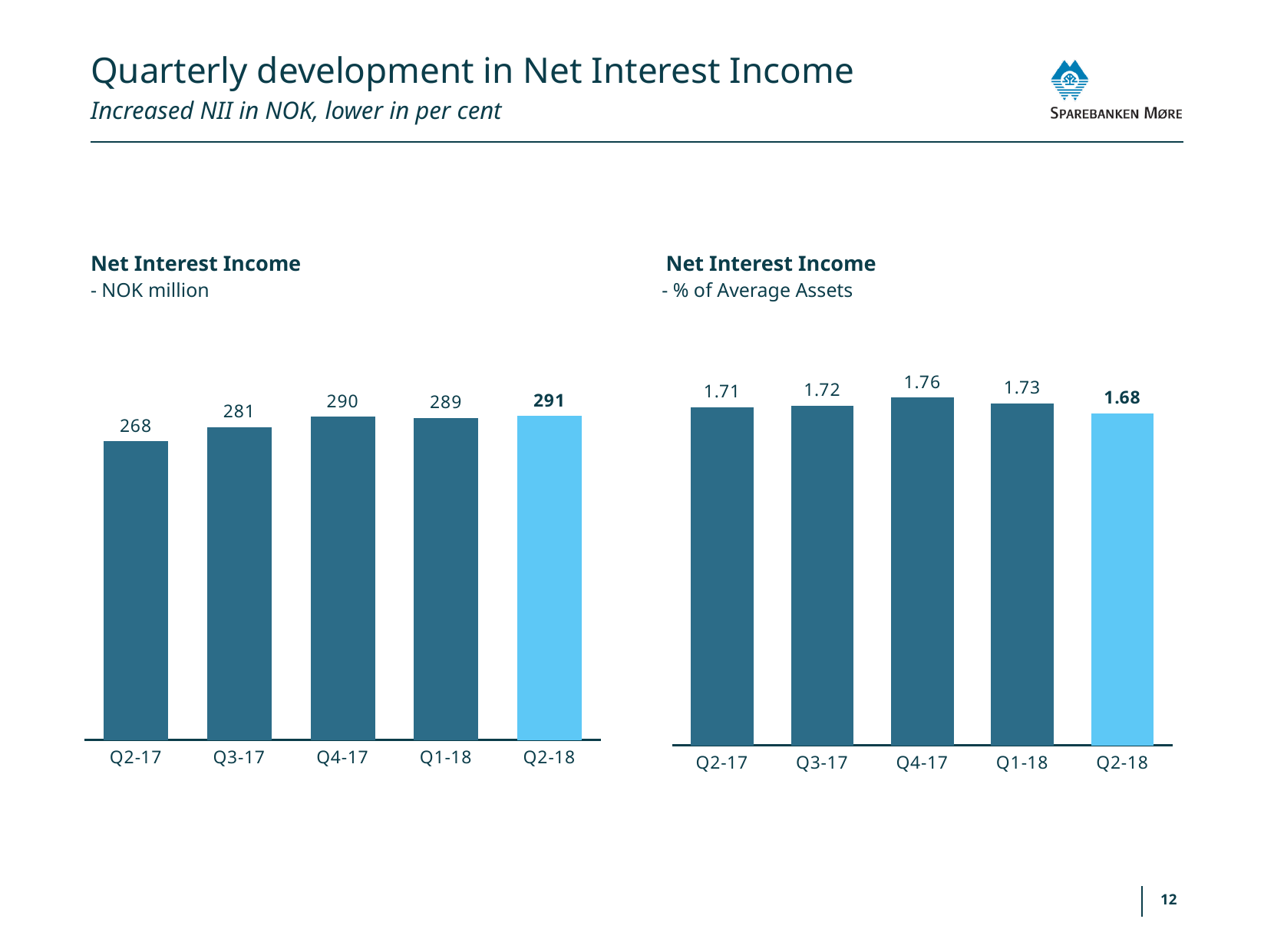
In the left chart (Net Interest Income - NOK million), which is larger, Q3-17 or Q1-18? Q1-18 In the left chart (Net Interest Income - NOK million), how many quarters are shown? 5 In the right chart (Net Interest Income - % of Average Assets), what is the value for Q2-18? 1.68 In the left chart (Net Interest Income - NOK million), what is the difference between Q2-18 and Q2-17? 23 In the left chart (Net Interest Income - NOK million), which quarter has the lowest value? Q2-17 In the right chart (Net Interest Income - % of Average Assets), what is the difference between Q4-17 and Q2-18? 0.08 In the right chart (Net Interest Income - % of Average Assets), what is the value for Q4-17? 1.76 In the left chart (Net Interest Income - NOK million), what is the value for Q2-17? 268 In the right chart (Net Interest Income - % of Average Assets), which quarter has the lowest value? Q2-18 What type of chart is the left chart (Net Interest Income - NOK million)? Bar chart In the right chart (Net Interest Income - % of Average Assets), which quarter has the highest value? Q4-17 In the left chart (Net Interest Income - NOK million), what is the value for Q2-18? 291